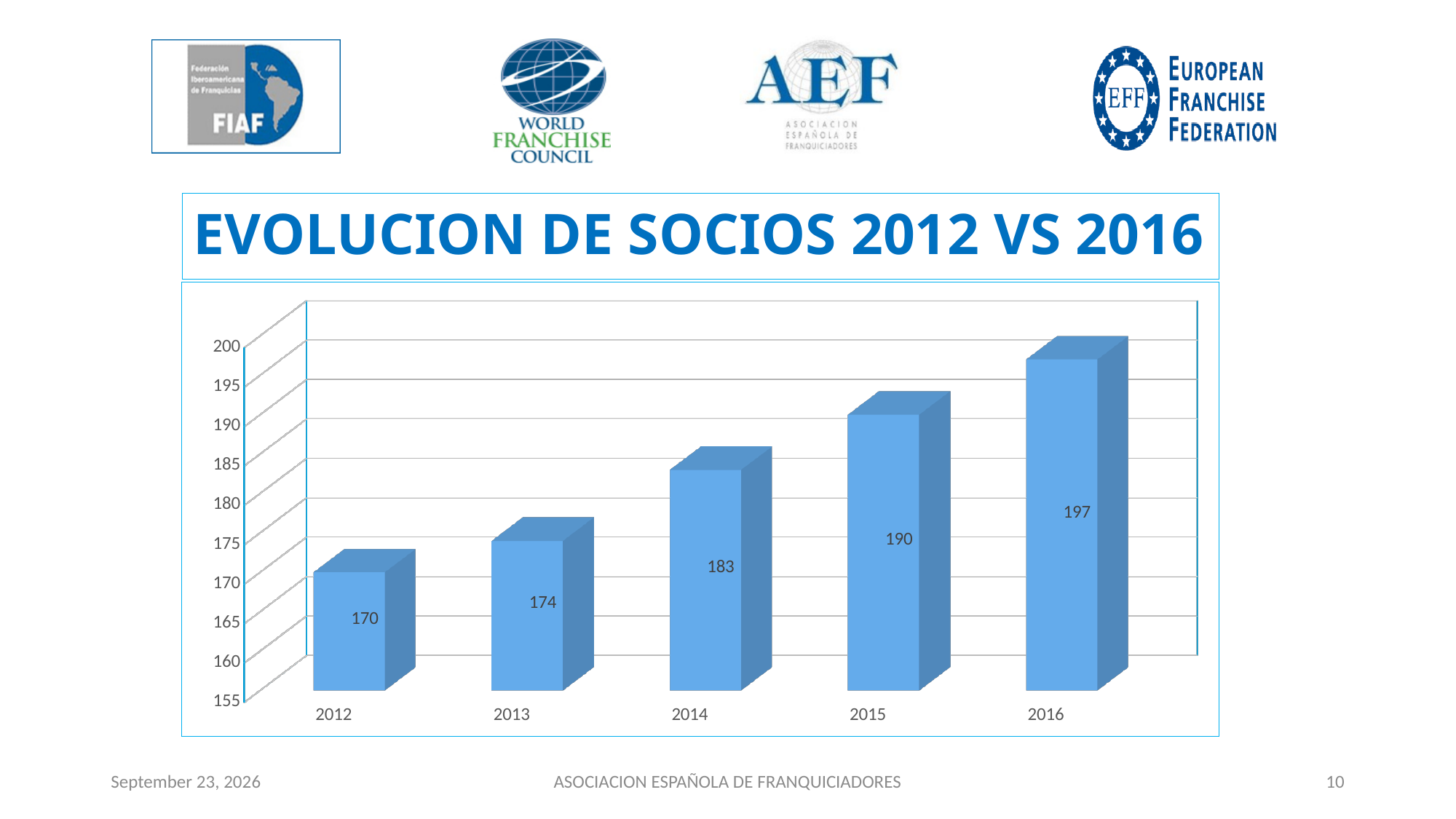
Which year has the lowest value? 2012 Is the value for 2013 greater or less than 180? less What is the value for 2014? 183 Do the values rise or fall from 2012 to 2016? rise How many years are shown on the chart? 5 Which is larger, the value for 2013 or the value for 2015? 2015 What is the value for 2012? 170 What is the difference between the values for 2015 and 2014? 7 Which year has the highest value? 2016 What kind of chart is shown on the slide? bar chart What is the value for 2016? 197 What is the difference between the values for 2016 and 2012? 27